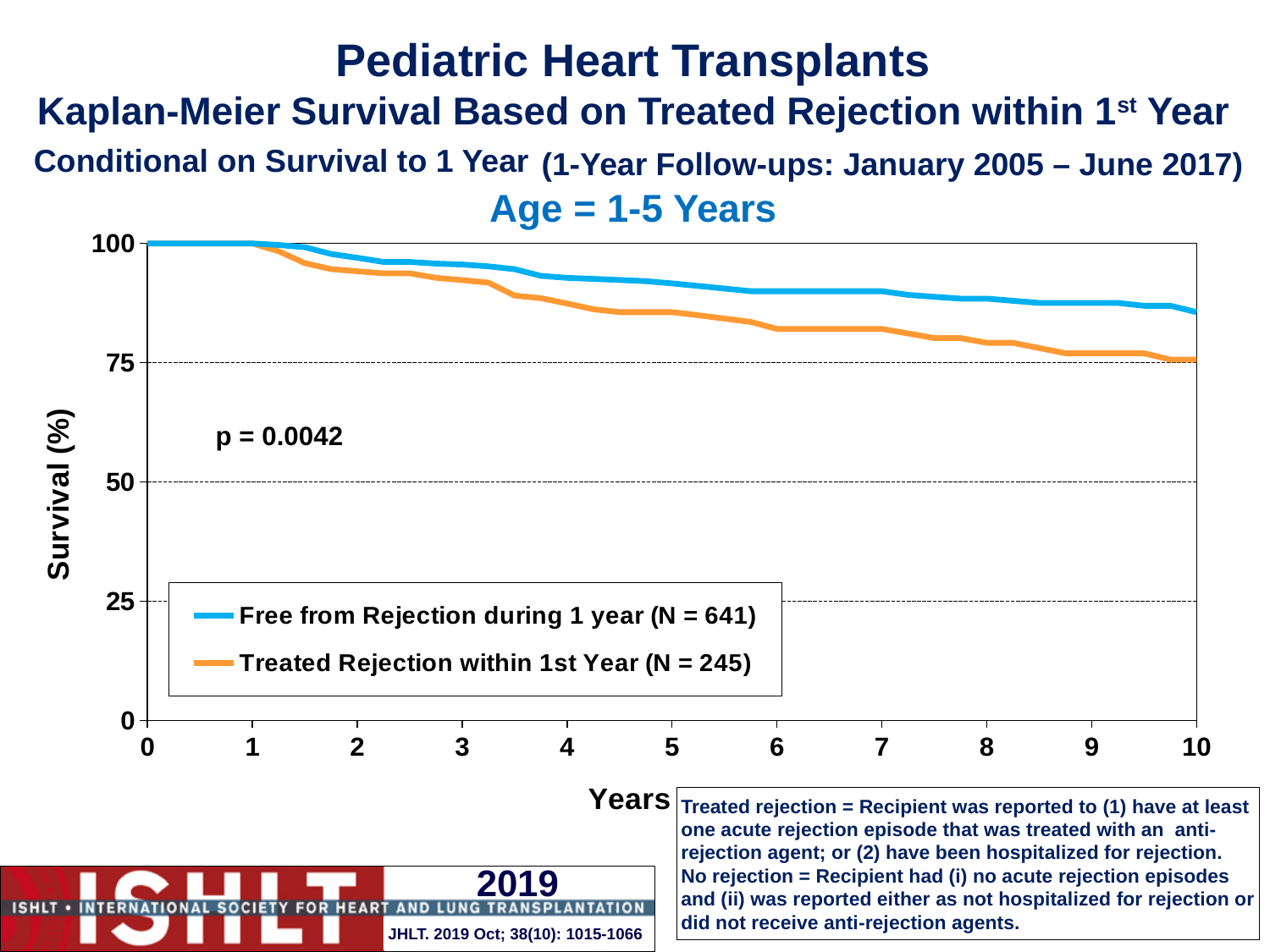
Do the survival values for the 'Treated Rejection within 1st Year' group rise or fall as years increase? Fall What kind of chart is shown on the slide? Line chart What p-value is printed on the chart? p = 0.0042 Is the survival for the 'Free from Rejection during 1 year' group at 10 years greater or less than 75? greater Is the survival for the 'Treated Rejection within 1st Year' group at 8 years greater or less than 100? less At 6 years, which group has the lower survival? Treated Rejection within 1st Year Is the survival for the 'Treated Rejection within 1st Year' group at 5 years greater or less than 75? greater How many series does the legend list? 2 Do the survival values for the 'Free from Rejection during 1 year' group rise or fall along the x axis? Fall At 10 years, which group has the higher survival: 'Free from Rejection during 1 year' or 'Treated Rejection within 1st Year'? Free from Rejection during 1 year What is the N for the 'Free from Rejection during 1 year' group shown in the legend? 641